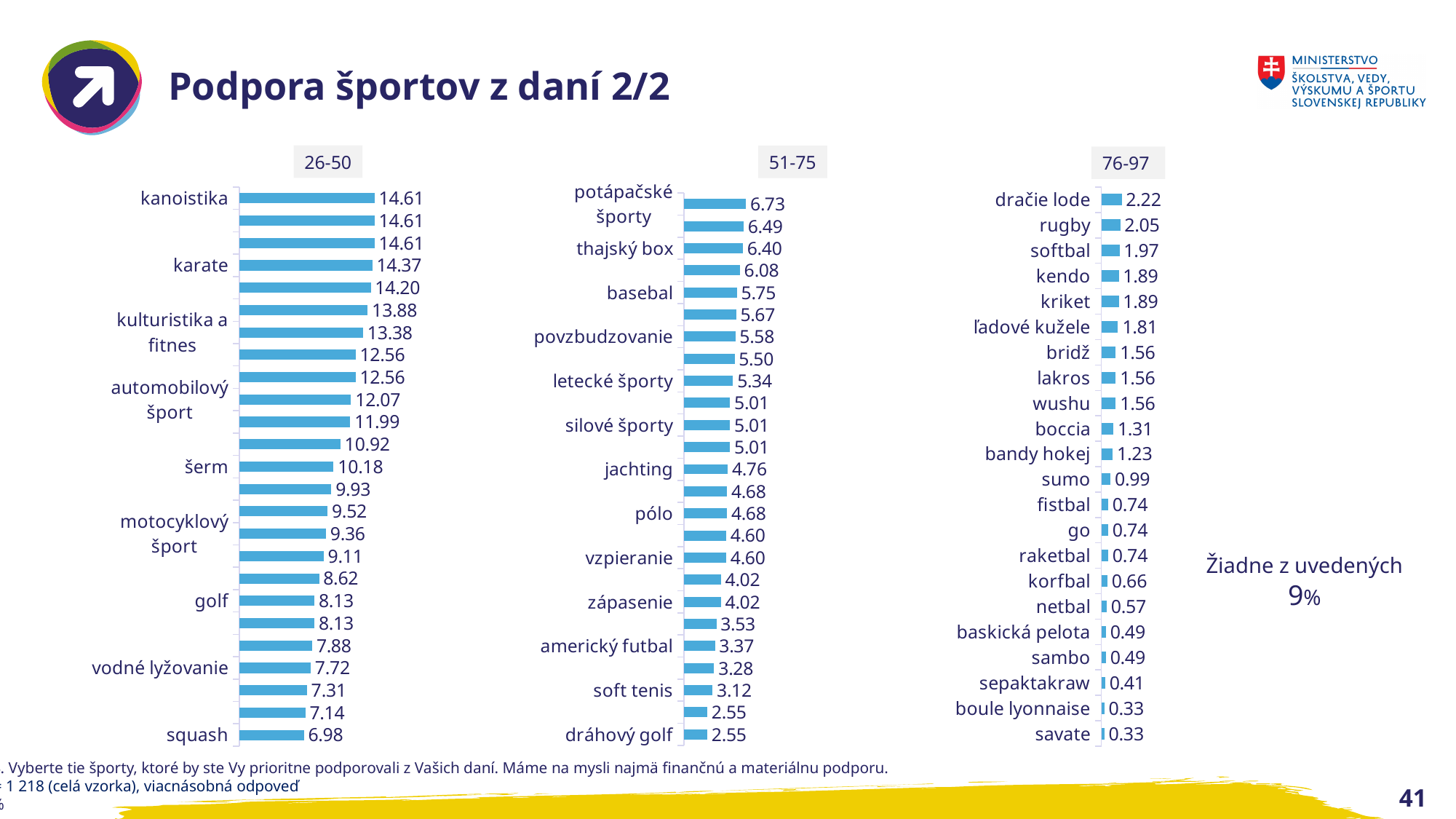
In the chart labelled 51-75, what is the value for thajský box? 6.40 In the chart labelled 26-50, what is the value for kanoistika? 14.61 In the chart labelled 76-97, what is the difference between the values for dračie lode and rugby? 0.17 In the chart labelled 76-97, how many categories are plotted? 22 In the chart labelled 76-97, what is the value for boccia? 1.31 What kind of chart is the chart labelled 51-75? bar chart In the chart labelled 26-50, do the values rise or fall going from the top bar to the bottom bar? fall What is the title of the slide? Podpora športov z daní 2/2 In the chart labelled 76-97, which has the larger value, rugby or softbal? rugby In the chart labelled 51-75, what is the value for jachting? 4.76 In the chart labelled 26-50, what is the value for squash? 6.98 In the chart labelled 76-97, which category has the highest value? dračie lode